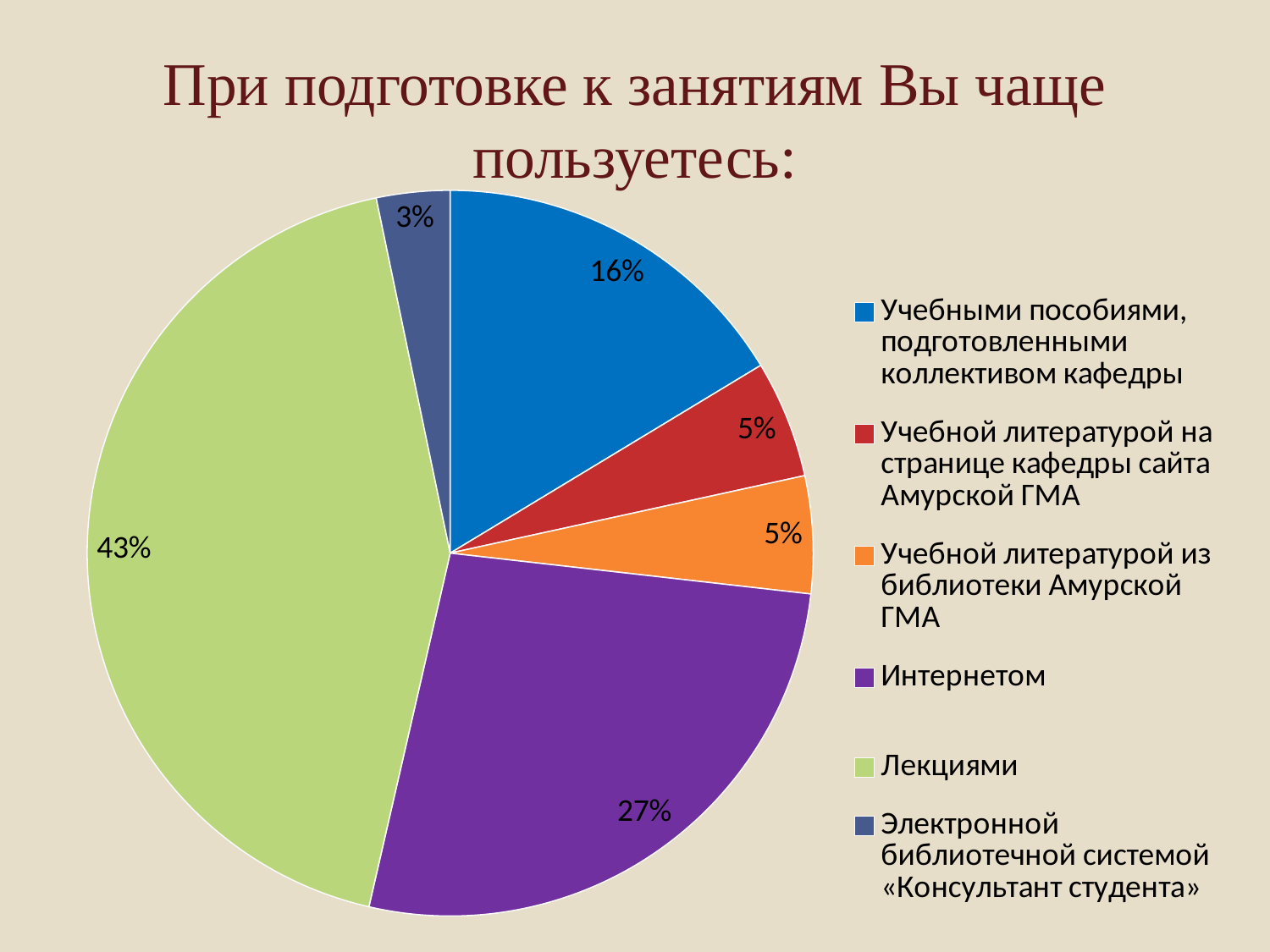
What share of the pie is labelled "Интернетом"? 27% What is the value for "Учебной литературой из библиотеки Амурской ГМА"? 5% What is the title of the chart? При подготовке к занятиям Вы чаще пользуетесь: Which category has the smallest slice? Электронной библиотечной системой «Консультант студента» How many categories does the legend list? 6 Which category has the largest slice? Лекциями What is the value for "Учебными пособиями, подготовленными коллективом кафедры"? 16% What kind of chart is shown on the slide? pie chart What is the value for "Электронной библиотечной системой «Консультант студента»"? 3% What share of the pie is labelled "Лекциями"? 43% Which is larger: the share for "Интернетом" or the share for "Учебными пособиями, подготовленными коллективом кафедры"? Интернетом What is the difference between the shares for "Лекциями" and "Интернетом"? 16%